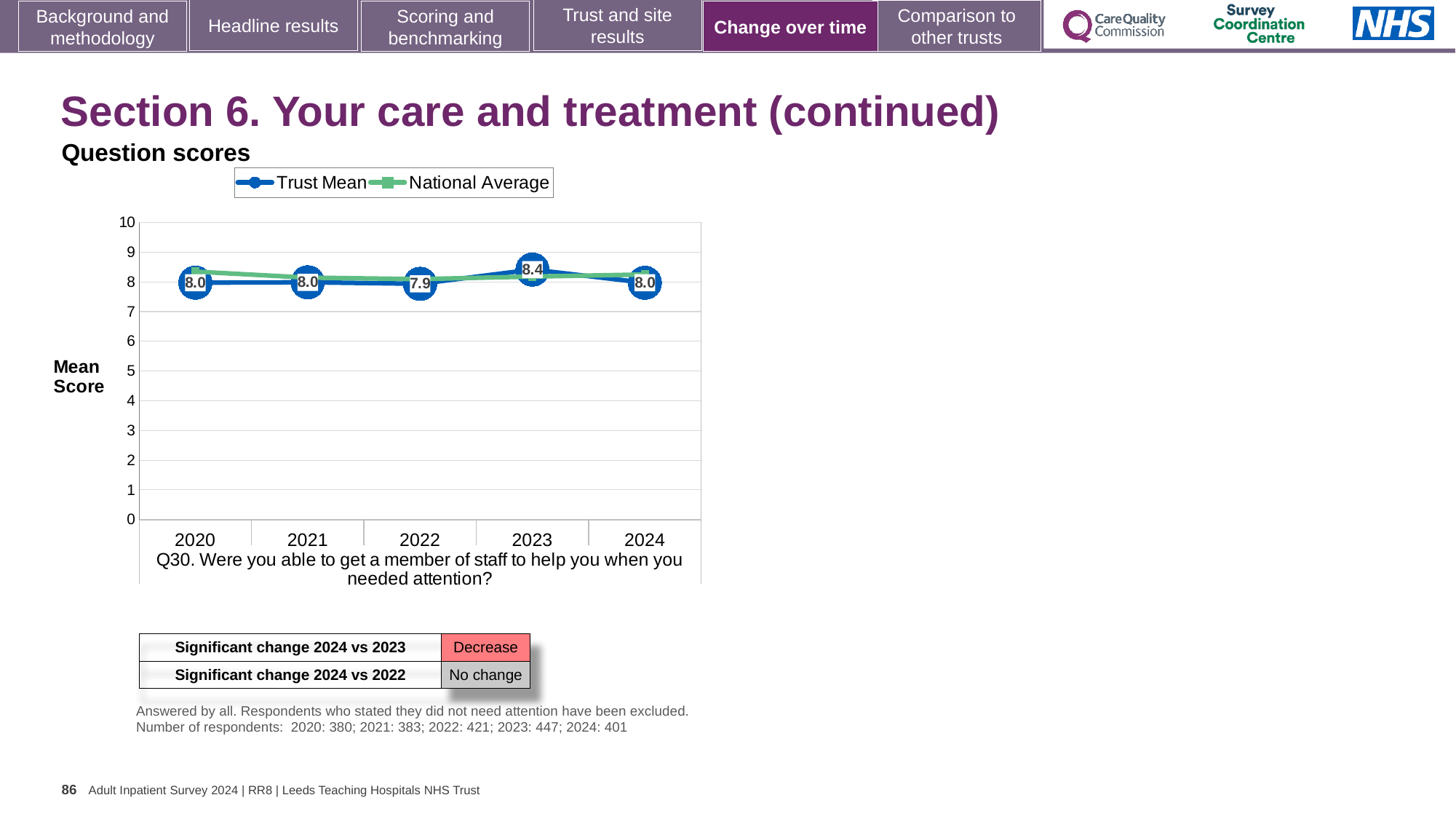
How many series does the legend list on the Q30 chart? 2 What is the Trust Mean score for 2023 on the Q30 chart? 8.4 How many years are plotted on the Q30 chart? 5 What is the difference between the Trust Mean in 2023 and in 2022? 0.5 In which year is the Trust Mean lowest on the Q30 chart? 2022 What is the Trust Mean score for 2020 on the Q30 chart? 8.0 What is the Trust Mean score for 2022 on the Q30 chart? 7.9 Is the National Average value for 2020 greater or less than 5? greater Which year has the larger Trust Mean, 2023 or 2024? 2023 Does the Trust Mean rise or fall from 2023 to 2024 on the Q30 chart? fall What kind of chart is used to show the Q30 question scores? line chart In which year is the Trust Mean highest on the Q30 chart? 2023